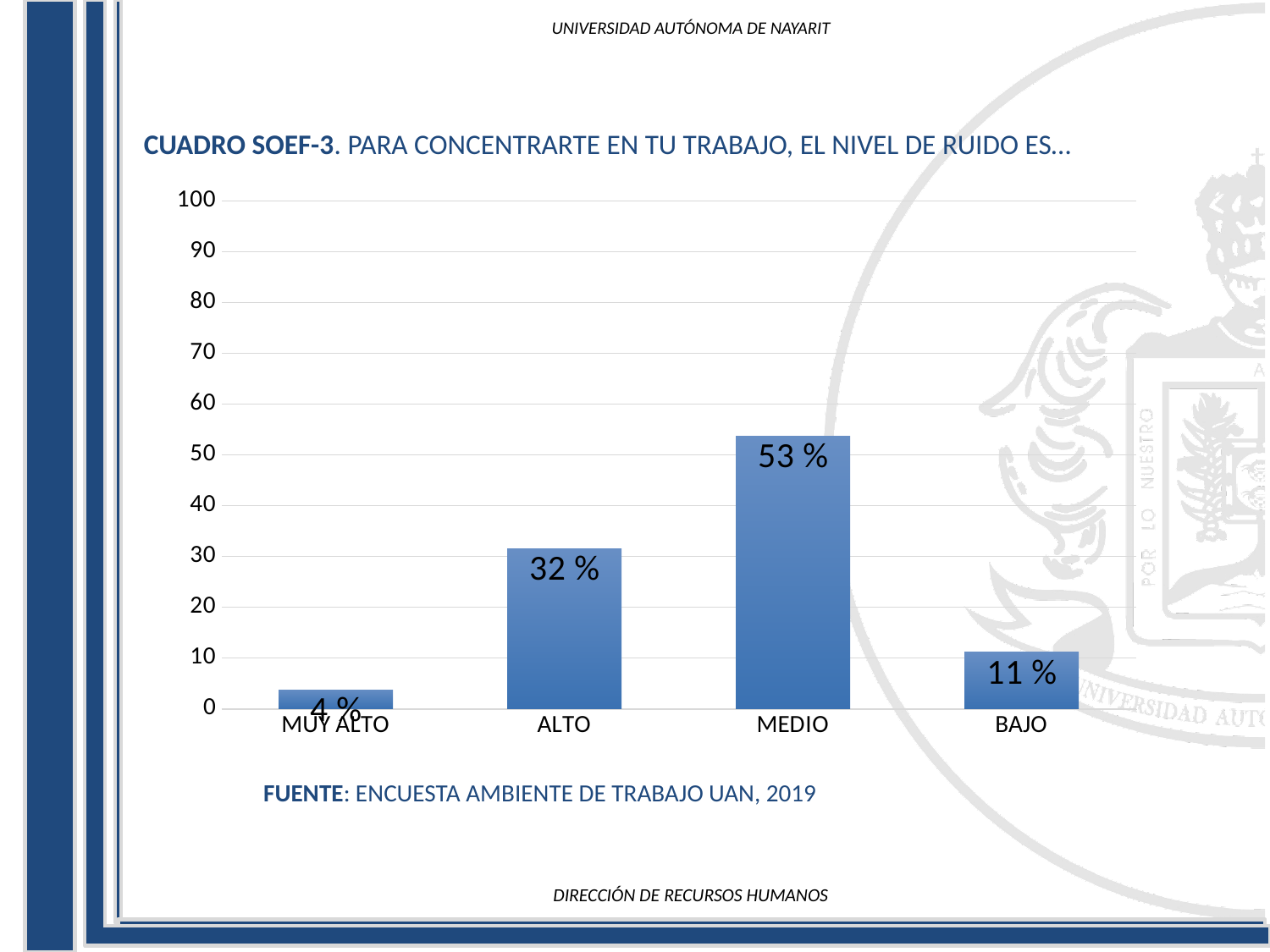
What is the difference between the values for MEDIO and ALTO? 21 % How many categories are shown on the x axis? 4 Which category has the lowest value? MUY ALTO Which category has the highest value? MEDIO What is the difference between the values for BAJO and MUY ALTO? 7 % Which is larger, the value for ALTO or the value for BAJO? ALTO Is the value for MEDIO greater or less than 50? greater What is the value for BAJO? 11 % What is the value for MUY ALTO? 4 % What is the value for MEDIO? 53 % What kind of chart is shown on the slide? bar chart What is the value for ALTO? 32 %